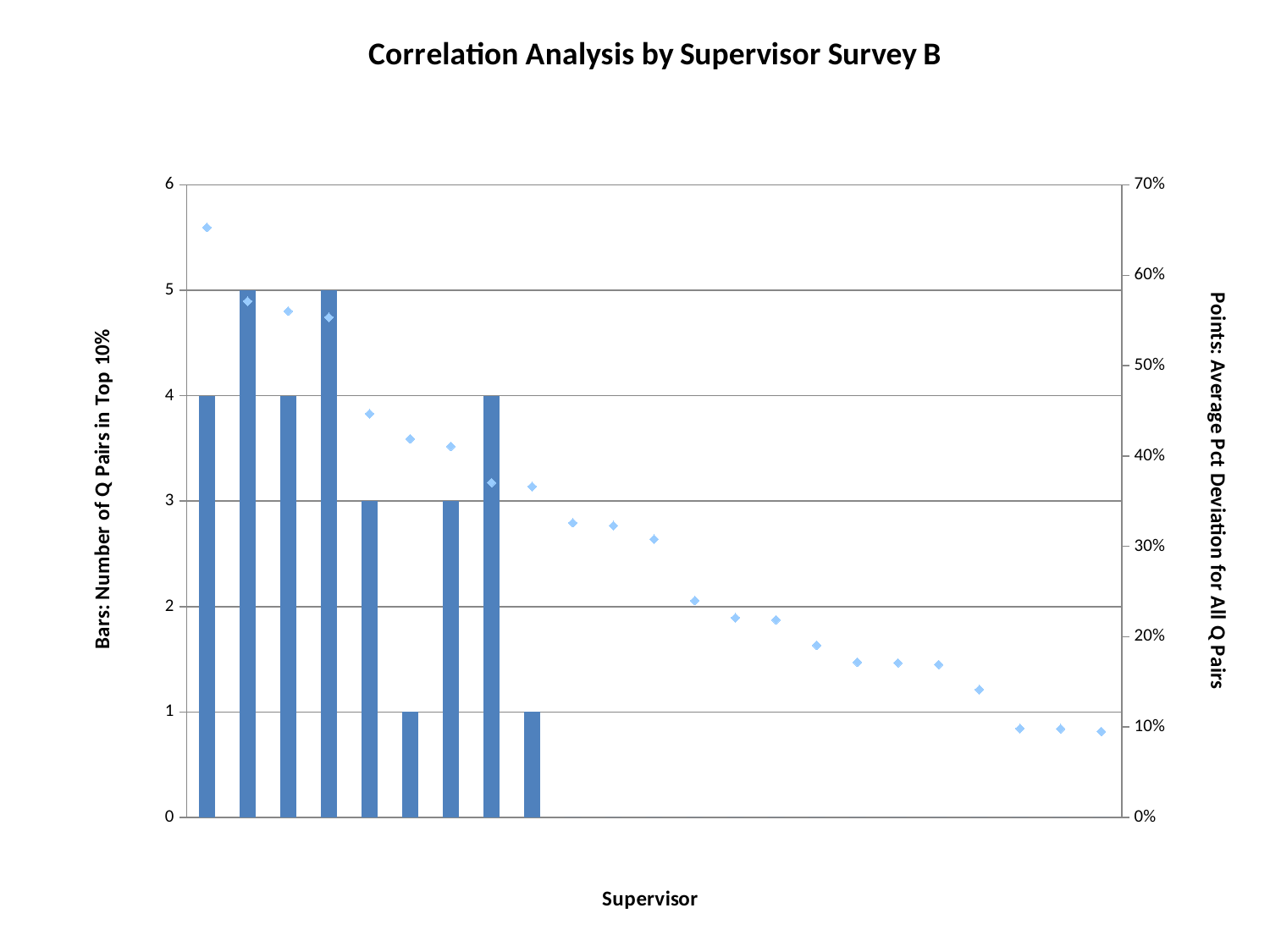
What is the value of the second bar from the left? 5 What is the title of the chart? Correlation Analysis by Supervisor Survey B What is the lowest bar value shown on the chart? 1 What is the highest bar value shown on the chart? 5 What kind of chart is this? Combination bar and scatter (points) chart What is the difference between the tallest bar value and the shortest bar value? 4 Do the points (Average Pct Deviation for All Q Pairs) generally rise or fall from left to right? Fall What is the value of the leftmost bar (Number of Q Pairs in Top 10%)? 4 What is the label of the horizontal axis? Supervisor Is the value of the rightmost point (Average Pct Deviation) greater or less than 20%? less Is the value of the leftmost point (Average Pct Deviation) greater or less than 60%? greater How many bars are plotted on the chart? 9